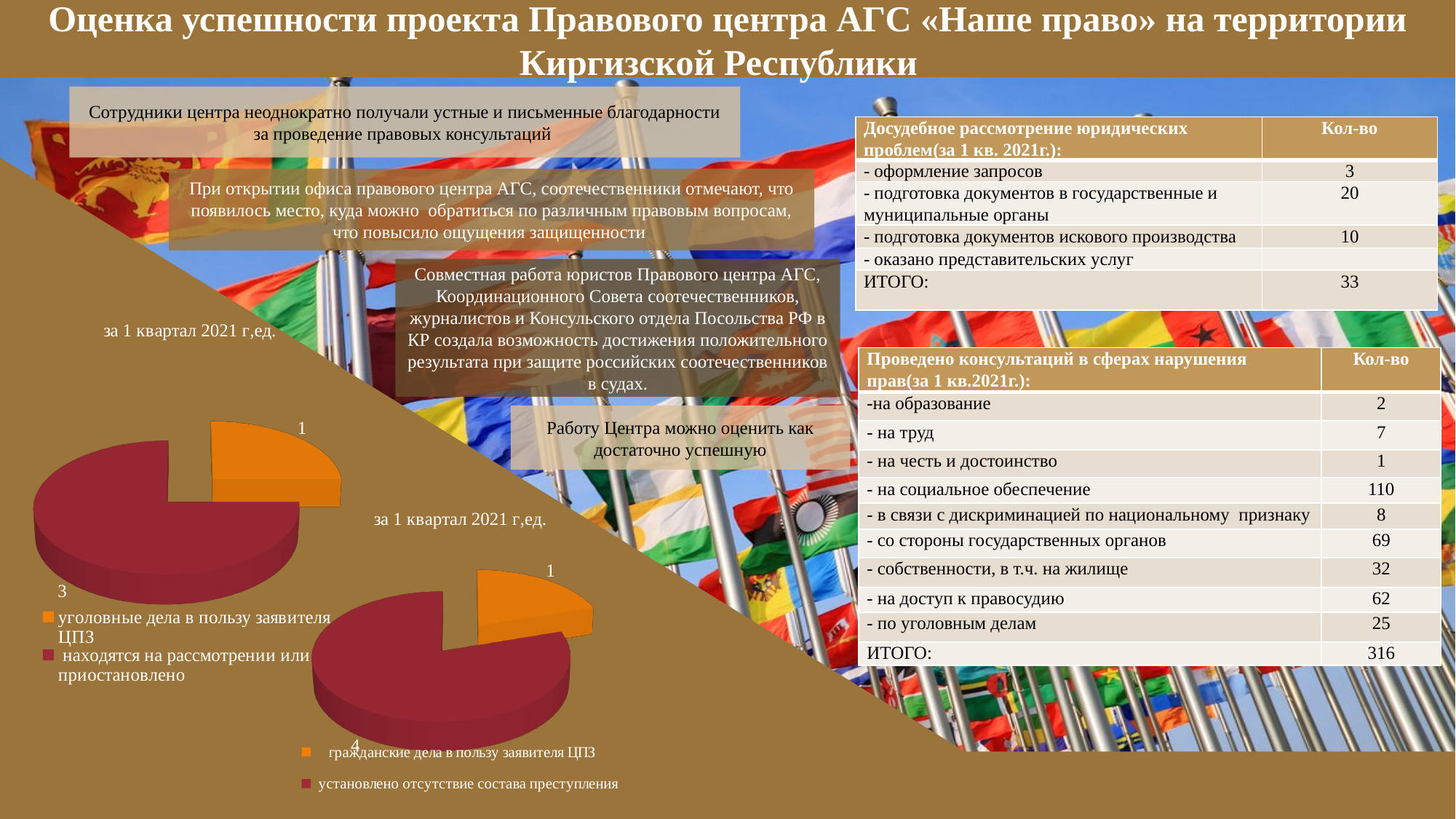
In the lower-right pie chart, what is the value for 'установлено отсутствие состава преступления'? 4 In the upper-left pie chart, what is the value for 'находятся на рассмотрении или приостановлено'? 3 In the upper-left pie chart, which is larger: 'уголовные дела в пользу заявителя ЦПЗ' or 'находятся на рассмотрении или приостановлено'? находятся на рассмотрении или приостановлено In the lower-right pie chart, what colour is the slice for 'гражданские дела в пользу заявителя ЦПЗ'? Orange In the upper-left pie chart, which category has the largest slice? находятся на рассмотрении или приостановлено What type of chart is the upper-left chart? Pie chart In the lower-right pie chart, what is the difference between 'установлено отсутствие состава преступления' and 'гражданские дела в пользу заявителя ЦПЗ'? 3 In the lower-right pie chart, which category has the smallest slice? гражданские дела в пользу заявителя ЦПЗ In the upper-left pie chart, what share of the total does 'находятся на рассмотрении или приостановлено' represent? 75% In the upper-left pie chart, what is the value for 'уголовные дела в пользу заявителя ЦПЗ'? 1 How many slices does the lower-right pie chart have? 2 In the lower-right pie chart, what is the value for 'гражданские дела в пользу заявителя ЦПЗ'? 1